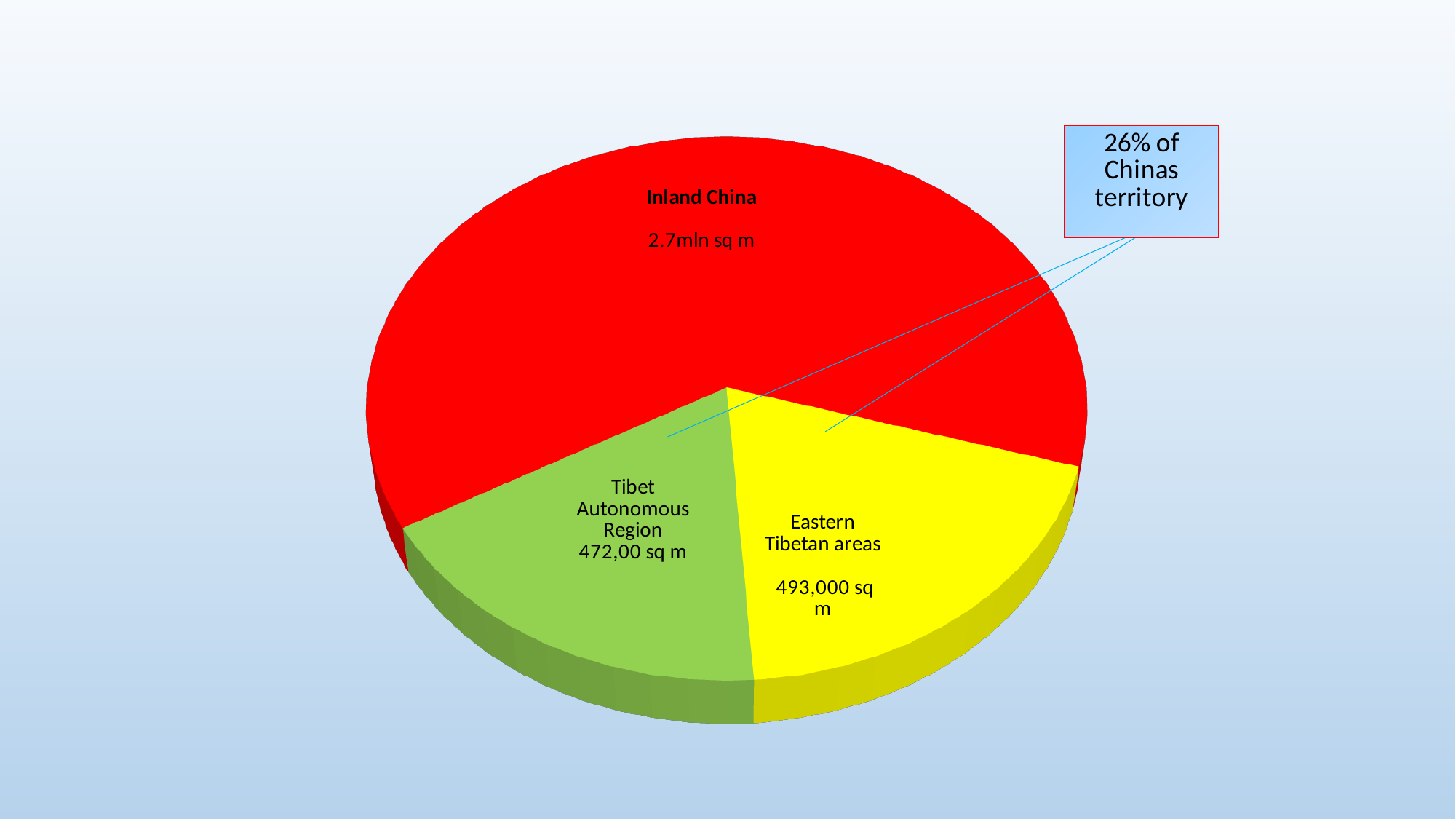
According to the callout, what share of China's territory do the Tibet Autonomous Region and Eastern Tibetan areas together make up? 26% Which is larger, Inland China or Eastern Tibetan areas? Inland China What colour is the Inland China slice? Red What kind of chart is shown on the slide? Pie chart Which is larger, Inland China or Tibet Autonomous Region? Inland China How many slices does the pie chart have? 3 What value is shown for Tibet Autonomous Region? 472,00 sq m What value is shown for Eastern Tibetan areas? 493,000 sq m What value is shown for Inland China? 2.7mln sq m Which slice of the pie chart is the largest? Inland China